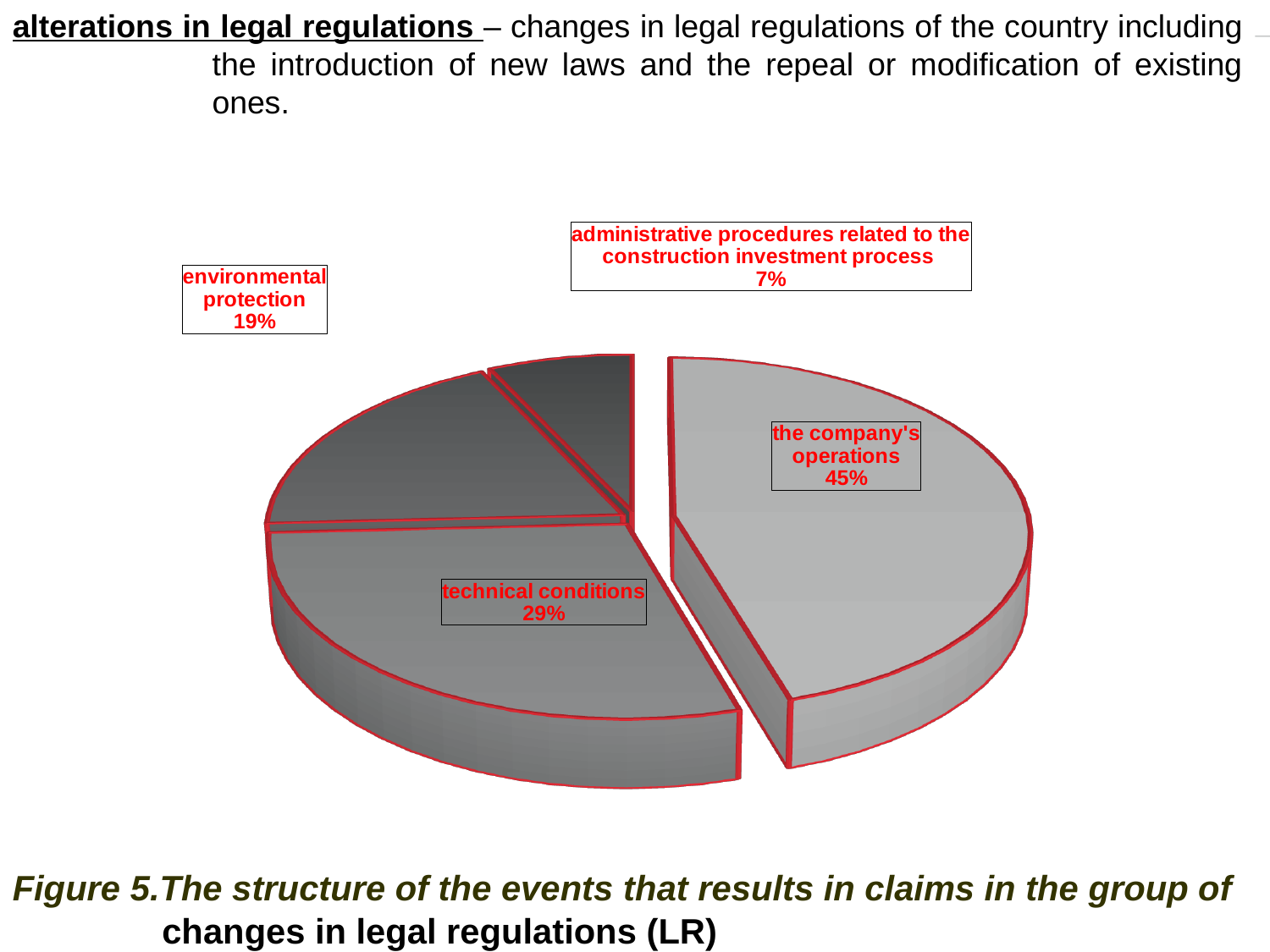
What percentage is shown for "technical conditions"? 29% Which category has the largest share of the pie? the company's operations What kind of chart is shown on the slide? pie chart What share of the pie is labelled "the company's operations"? 45% Which category has the smallest share of the pie? administrative procedures related to the construction investment process What is the figure number given in the caption below the chart? Figure 5 What is the difference in percentage points between "the company's operations" and "technical conditions"? 16 What is the difference in percentage points between "environmental protection" and "administrative procedures related to the construction investment process"? 12 What percentage is shown for "administrative procedures related to the construction investment process"? 7% Which is larger: the share for "environmental protection" or the share for "technical conditions"? technical conditions What percentage is shown for "environmental protection"? 19% How many slices does the pie chart have? 4